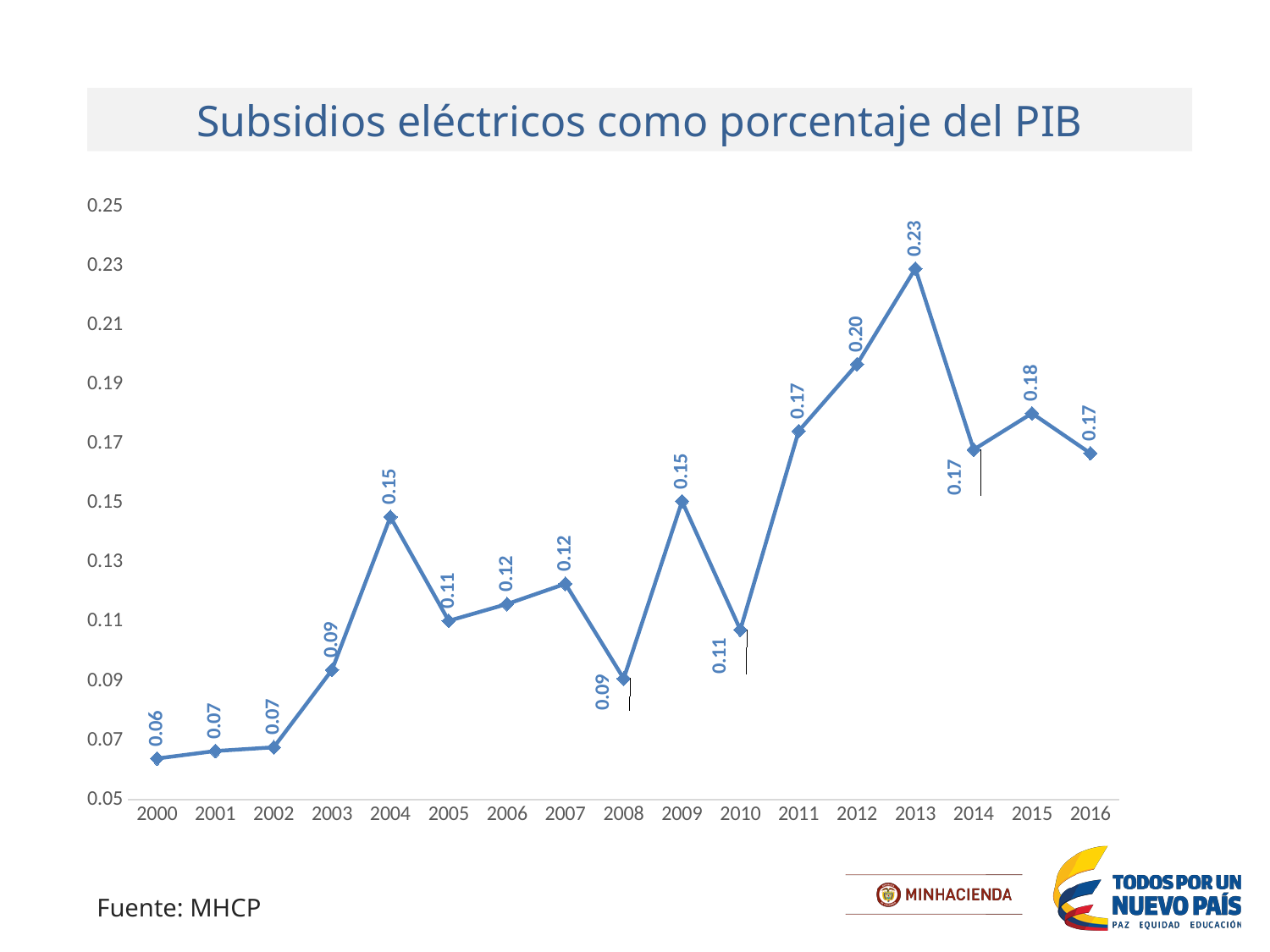
What is the value for 2016? 0.17 What is the value for 2004? 0.15 How many years are plotted on the x axis? 17 What is the value for 2008? 0.09 Which year has the lowest value? 2000 Is the value for 2011 greater or less than 0.15? greater Which year has the highest value? 2013 What is the title of the chart? Subsidios eléctricos como porcentaje del PIB What kind of chart is shown? line chart Which is larger, the value for 2012 or the value for 2015? 2012 What is the value for 2013? 0.23 What is the difference between the values for 2013 and 2000? 0.17